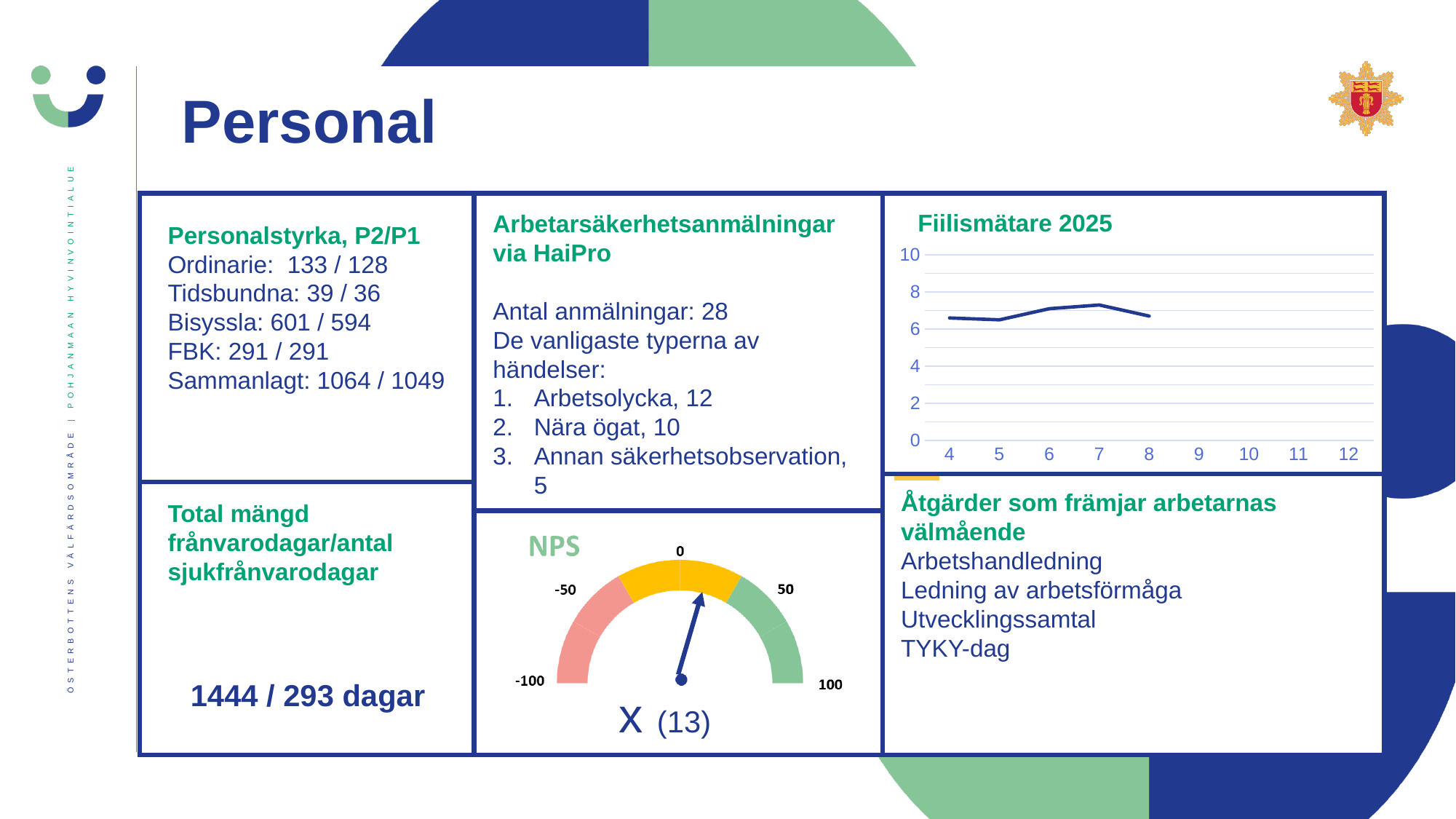
In the Fiilismätare 2025 chart, which has the higher value, x = 4 or x = 7? 7 In the Fiilismätare 2025 chart, is the value at x = 7 greater or less than 6? greater What kind of chart is the NPS chart at the bottom centre of the slide? gauge chart In the Fiilismätare 2025 chart, is the value at x = 4 greater or less than 8? less What is the title of the line chart on the right side of the slide? Fiilismätare 2025 What kind of chart is the Fiilismätare 2025 chart? line chart In the Fiilismätare 2025 chart, is the value at x = 8 greater or less than 4? greater In the Fiilismätare 2025 chart, how many data points are plotted on the line? 5 In the Fiilismätare 2025 chart, does the line rise or fall between x = 5 and x = 7? rise In the Fiilismätare 2025 chart, does the line rise or fall between x = 7 and x = 8? fall In the Fiilismätare 2025 chart, which has the higher value, x = 7 or x = 8? 7 What is the highest value shown on the y axis of the Fiilismätare 2025 chart? 10